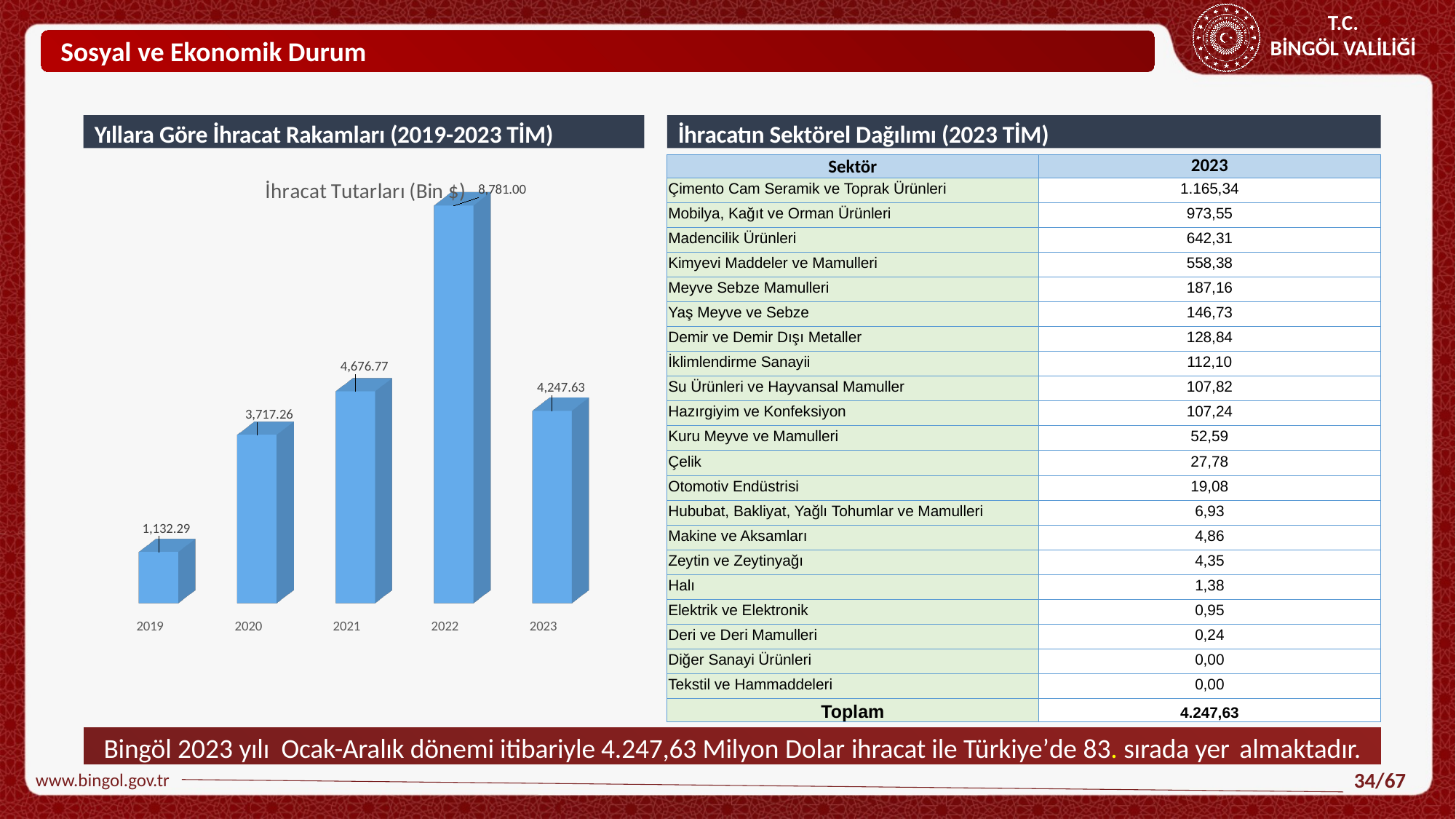
What is the value for 2022 in the chart? 8,781.00 Which year has the highest value in the chart? 2022 What is the difference between the values for 2022 and 2021 in the chart? 4,104.23 What is the value for 2020 in the chart? 3,717.26 What is the value for 2019 in the chart? 1,132.29 What is the value for 2023 in the chart? 4,247.63 How many years are plotted in the chart? 5 What is the title of the chart on the slide? İhracat Tutarları (Bin $) What type of chart is shown on the slide? bar chart Do the values in the chart rise or fall from 2019 to 2022? rise Which is larger in the chart, the value for 2021 or the value for 2023? 2021 Which year has the lowest value in the chart? 2019